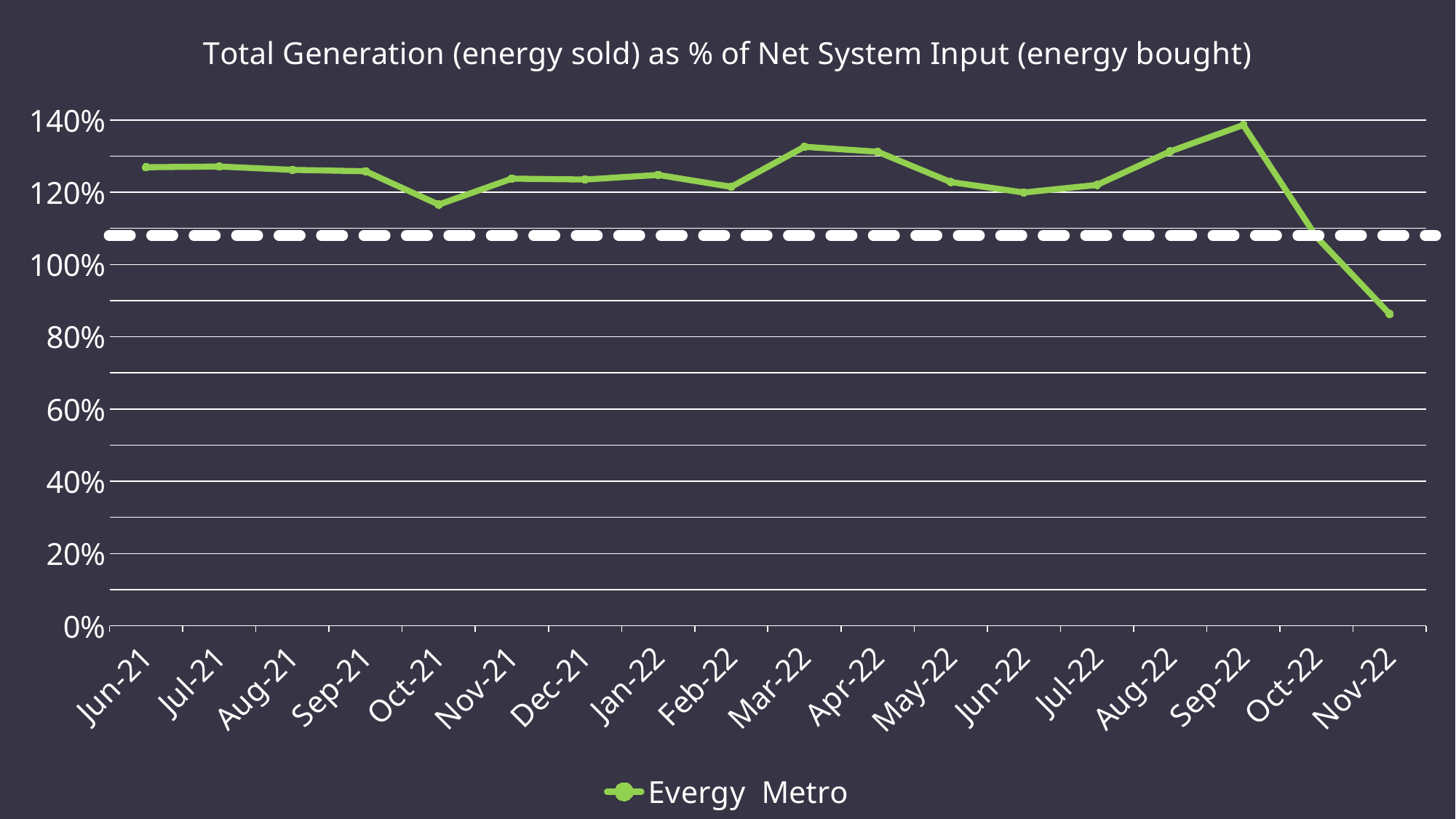
Do the values rise or fall from Sep-22 to Nov-22? fall What kind of chart is shown on the slide? line chart What is the name of the series shown in the legend? Evergy Metro Is the value for Nov-22 greater or less than 100%? less How many months are plotted along the x axis? 18 In which month is the Evergy Metro value highest? Sep-22 Is the value for Oct-21 greater or less than 120%? less Which is larger, the value for Mar-22 or the value for Oct-21? Mar-22 In which month is the Evergy Metro value lowest? Nov-22 How many series does the legend list? 1 What is the title of the chart? Total Generation (energy sold) as % of Net System Input (energy bought) Is the value for Sep-22 greater or less than 120%? greater